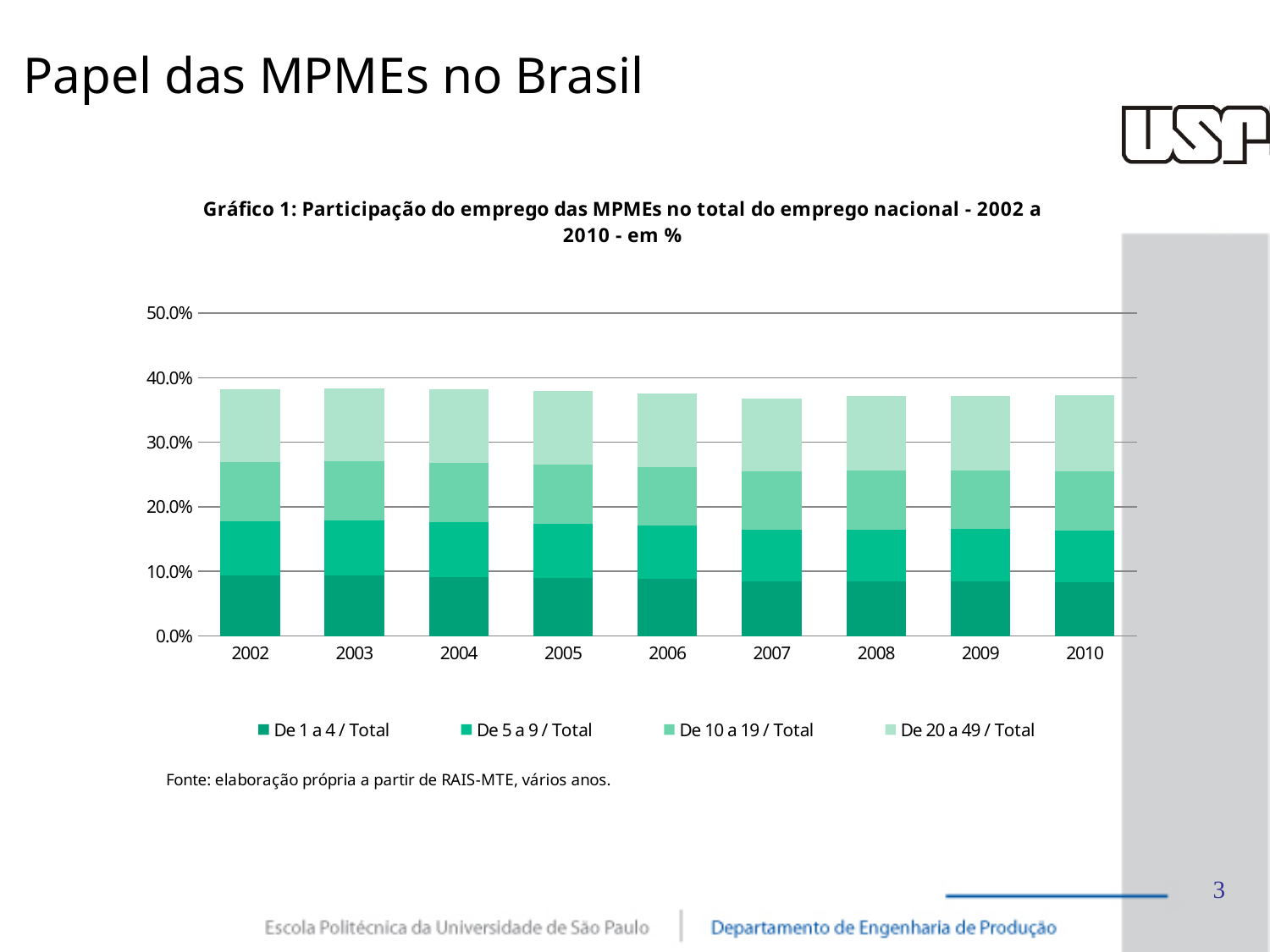
Which year has a taller total stacked bar, 2002 or 2007? 2002 How many years are shown on the x axis of the chart? 9 Is the top of the 'De 10 a 19 / Total' segment for 2005 greater or less than 30.0%? less Is the top of the 'De 5 a 9 / Total' segment for 2002 greater or less than 20.0%? less Is the total height of the stacked bar for 2002 greater or less than 40.0%? less What kind of chart is shown on the slide? Stacked bar chart What is the title of the chart? Gráfico 1: Participação do emprego das MPMEs no total do emprego nacional - 2002 a 2010 - em % Which series is listed first in the chart legend? De 1 a 4 / Total How many series does the chart legend list? 4 Does the total height of the stacked bars generally rise or fall from 2002 to 2010? fall